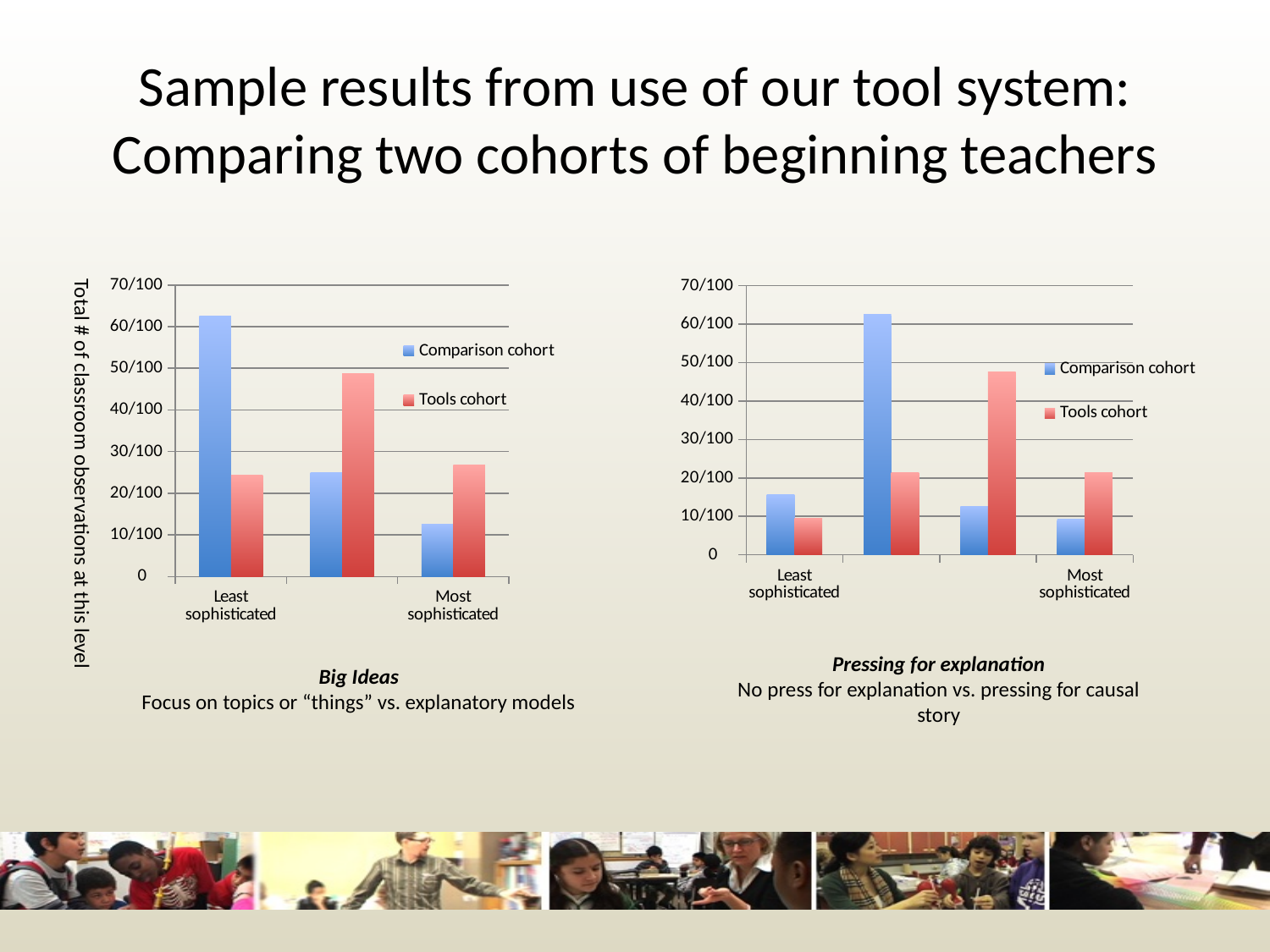
What kind of chart is the Big Ideas chart on the left? Bar chart In the Big Ideas chart, which cohort has the higher value for Most sophisticated? Tools cohort What is the y-axis label shown beside the Big Ideas chart? Total # of classroom observations at this level How many categories are plotted on the x axis of the Big Ideas chart? 3 In the Big Ideas chart, for which category is the Comparison cohort value highest? Least sophisticated How many series does the legend of the Pressing for explanation chart list? 2 In the Big Ideas chart, is the Tools cohort value for Most sophisticated greater or less than 20/100? greater In the Pressing for explanation chart, which cohort has the higher value for Least sophisticated? Comparison cohort In the Pressing for explanation chart, for which labelled category is the Tools cohort value lowest? Least sophisticated In the Big Ideas chart, is the Comparison cohort value for Least sophisticated greater or less than 60/100? greater How many categories are plotted on the x axis of the Pressing for explanation chart? 4